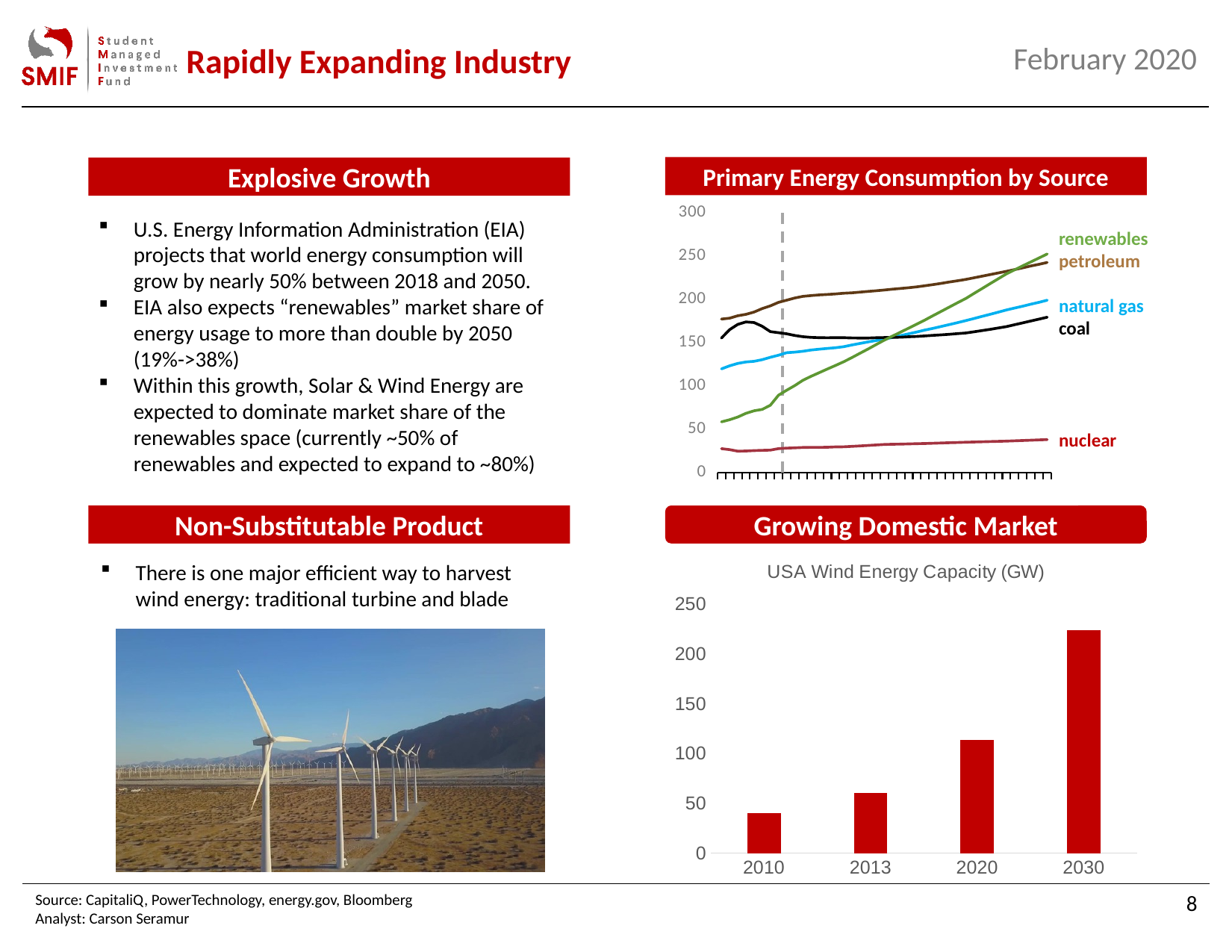
In the USA Wind Energy Capacity (GW) chart, which year has the lowest capacity? 2010 What kind of chart is the USA Wind Energy Capacity (GW) chart? bar chart In the Primary Energy Consumption by Source chart, does the renewables line rise or fall along the x axis? rise In the USA Wind Energy Capacity (GW) chart, is the value for 2010 greater or less than 50? less In the USA Wind Energy Capacity (GW) chart, which year has the highest capacity? 2030 How many energy sources are labelled in the Primary Energy Consumption by Source chart? 5 In the Primary Energy Consumption by Source chart, which source has the lowest consumption at the right end of the chart? nuclear In the USA Wind Energy Capacity (GW) chart, how many years are shown on the x axis? 4 In the USA Wind Energy Capacity (GW) chart, is the value for 2030 greater or less than 200? greater In the USA Wind Energy Capacity (GW) chart, do the values rise or fall from 2010 to 2030? rise What kind of chart is the Primary Energy Consumption by Source chart? line chart In the USA Wind Energy Capacity (GW) chart, is the value for 2020 greater or less than 100? greater